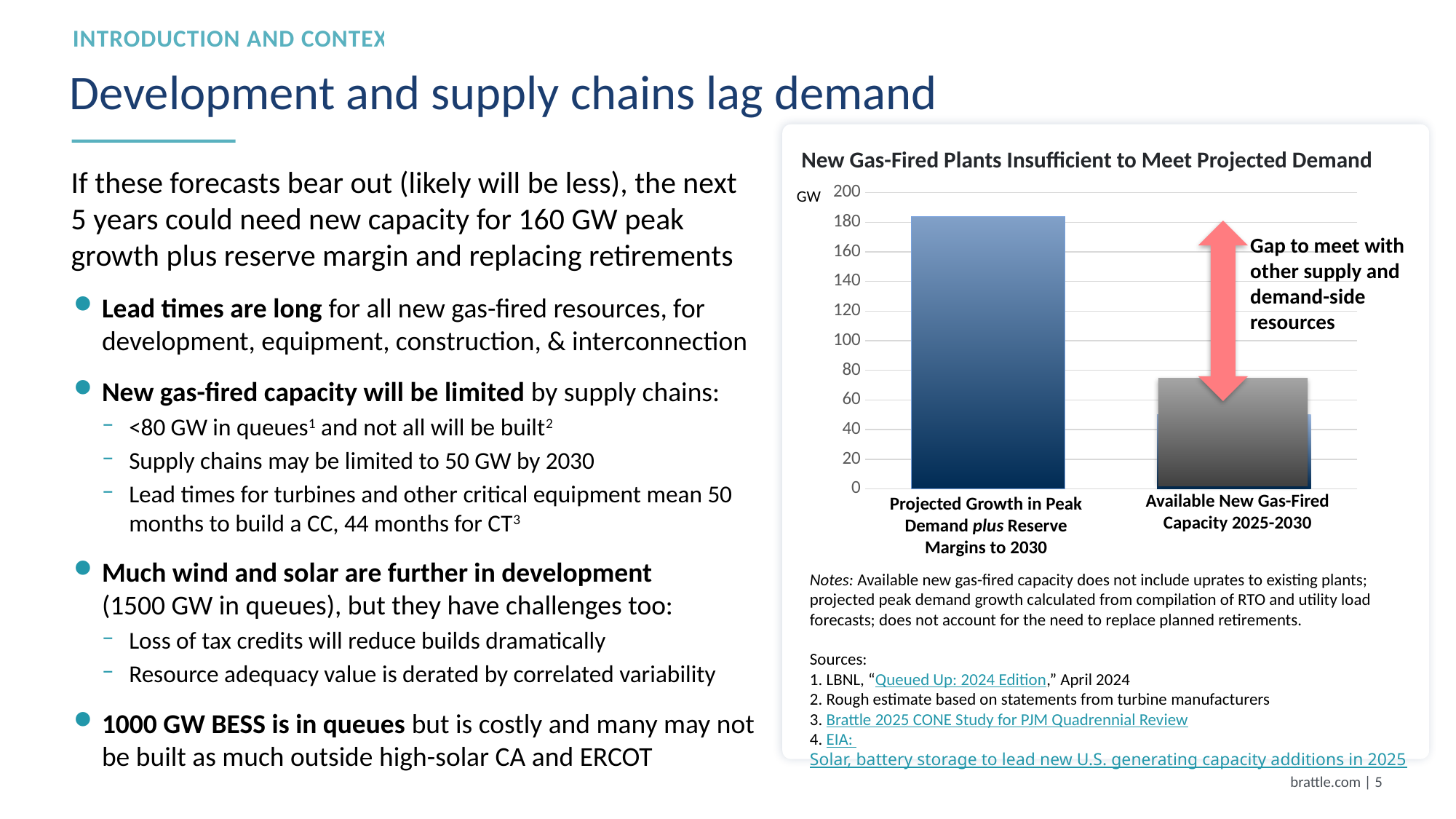
What kind of chart is shown on the slide? bar chart Which is larger: Projected Growth in Peak Demand plus Reserve Margins to 2030 or Available New Gas-Fired Capacity 2025-2030? Projected Growth in Peak Demand plus Reserve Margins to 2030 Which category has the lowest value in the chart? Available New Gas-Fired Capacity 2025-2030 What is the title of the chart? New Gas-Fired Plants Insufficient to Meet Projected Demand Is the value for Projected Growth in Peak Demand plus Reserve Margins to 2030 greater or less than 200? less Is the value for Projected Growth in Peak Demand plus Reserve Margins to 2030 greater or less than 160? greater What unit is shown on the vertical axis of the chart? GW Do the bar values rise or fall from left to right across the chart? fall Which category has the highest value in the chart? Projected Growth in Peak Demand plus Reserve Margins to 2030 Is the value for Available New Gas-Fired Capacity 2025-2030 greater or less than 100? less How many bars (categories) are plotted in the chart? 2